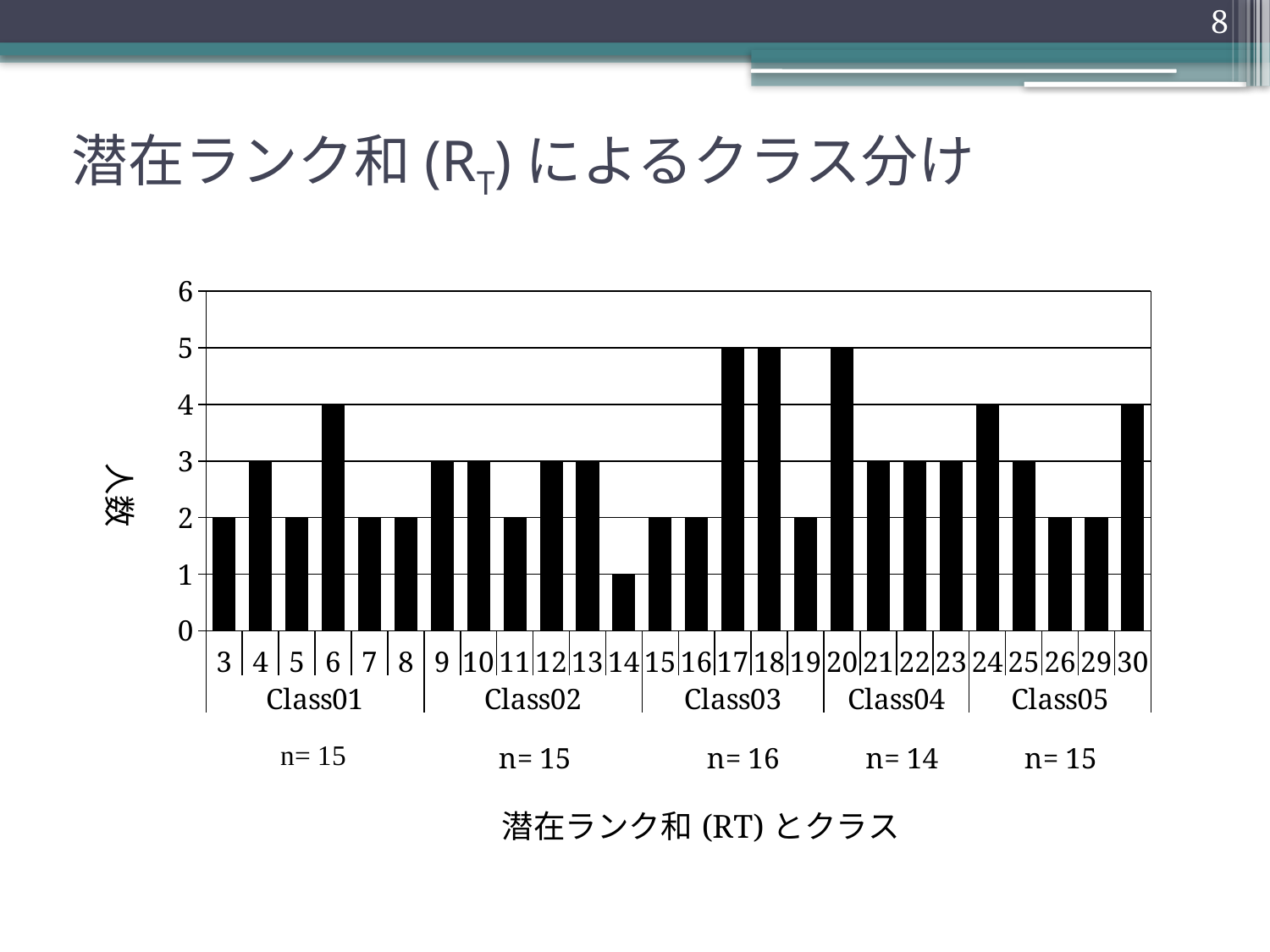
What is the value (人数) for RT = 20? 5 Which is larger, the value for RT = 17 or the value for RT = 19? 17 What is the value (人数) for RT = 14? 1 What is the value (人数) for RT = 25? 3 What is the n value shown for Class03? n= 16 What is the value (人数) for RT = 6? 4 What is the difference between the values for RT = 6 and RT = 3? 2 What type of chart is shown on the slide? bar chart What is the label of the y axis? 人数 How many RT categories are plotted on the x axis? 26 Which RT category has the lowest value? 14 How many classes (Class01 to Class05) are shown along the x axis? 5